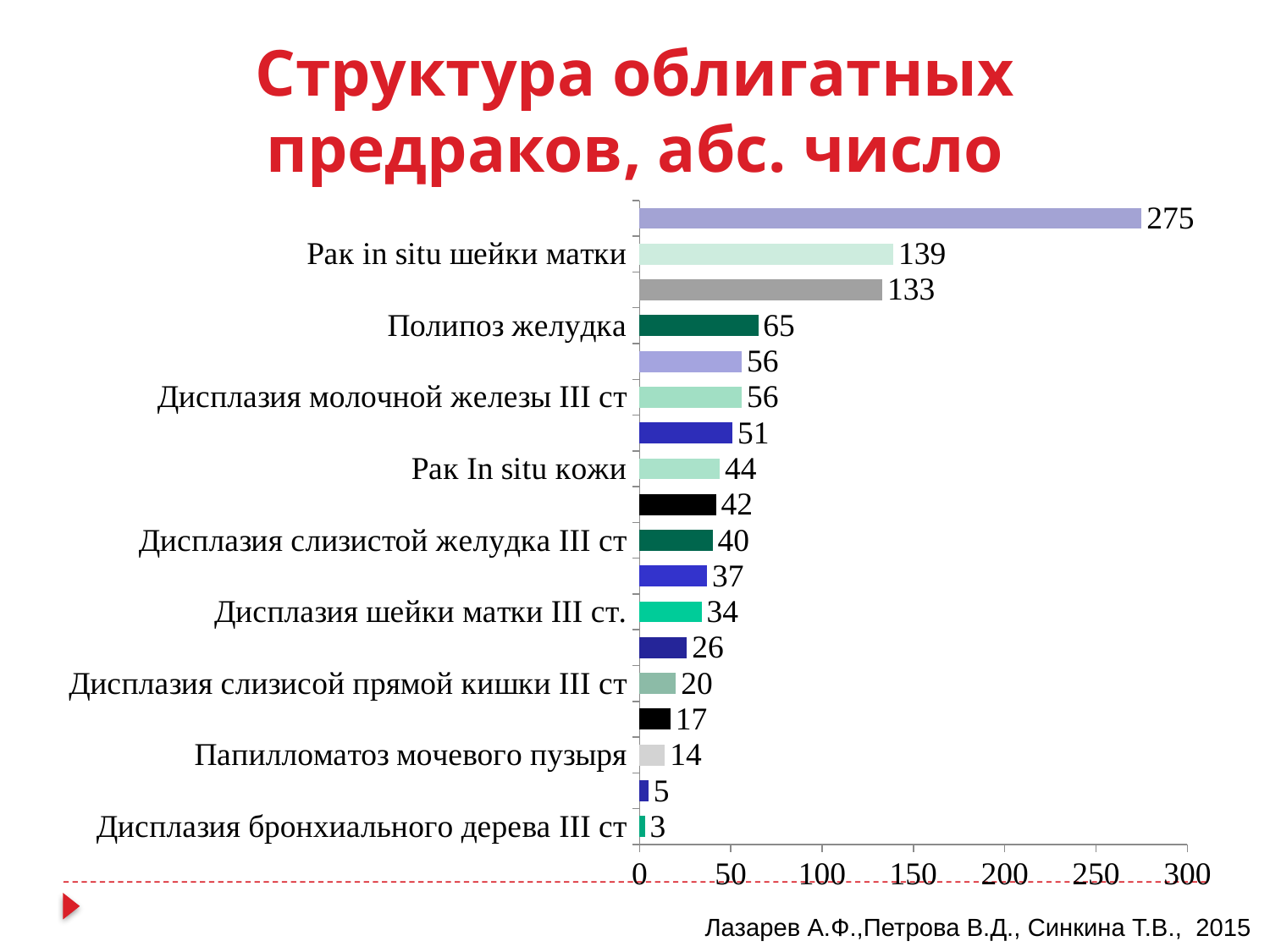
What is the value for Рак In situ кожи? 44 What is the value for Папилломатоз мочевого пузыря? 14 What is the difference between the values for Полипоз желудка and Рак In situ кожи? 21 What is the largest value shown on the chart? 275 Which category has the lowest value on the chart? Дисплазия бронхиального дерева III ст What kind of chart is shown on the slide? bar chart Which is larger: the value for Дисплазия слизистой желудка III ст or for Дисплазия шейки матки III ст.? Дисплазия слизистой желудка III ст What is the title of the slide? Структура облигатных предраков, абс. число What is the value for Полипоз желудка? 65 What is the value for Рак in situ шейки матки? 139 How many bars are plotted on the chart? 18 What is the value for Дисплазия шейки матки III ст.? 34